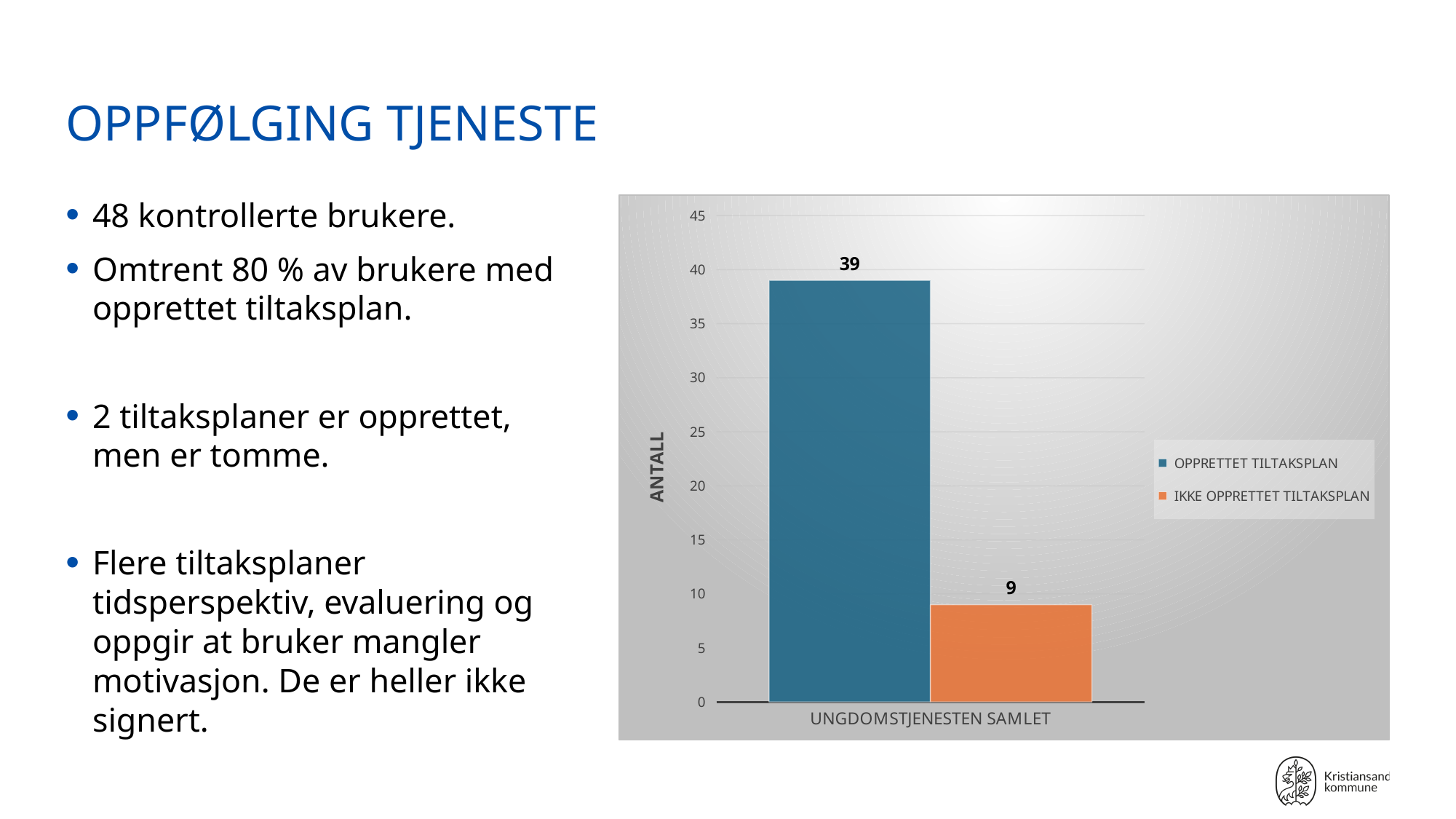
What is the label on the x axis category? UNGDOMSTJENESTEN SAMLET What is the value for IKKE OPPRETTET TILTAKSPLAN? 9 What kind of chart is shown on the slide? bar chart What is the difference between the values for OPPRETTET TILTAKSPLAN and IKKE OPPRETTET TILTAKSPLAN? 30 How many series does the legend list? 2 What is the value for OPPRETTET TILTAKSPLAN? 39 Which is larger, OPPRETTET TILTAKSPLAN or IKKE OPPRETTET TILTAKSPLAN? OPPRETTET TILTAKSPLAN Is the value for IKKE OPPRETTET TILTAKSPLAN greater or less than 10? less What is the label on the y axis? ANTALL Which series has the lowest value? IKKE OPPRETTET TILTAKSPLAN Which series has the highest value? OPPRETTET TILTAKSPLAN Is the value for OPPRETTET TILTAKSPLAN greater or less than 35? greater